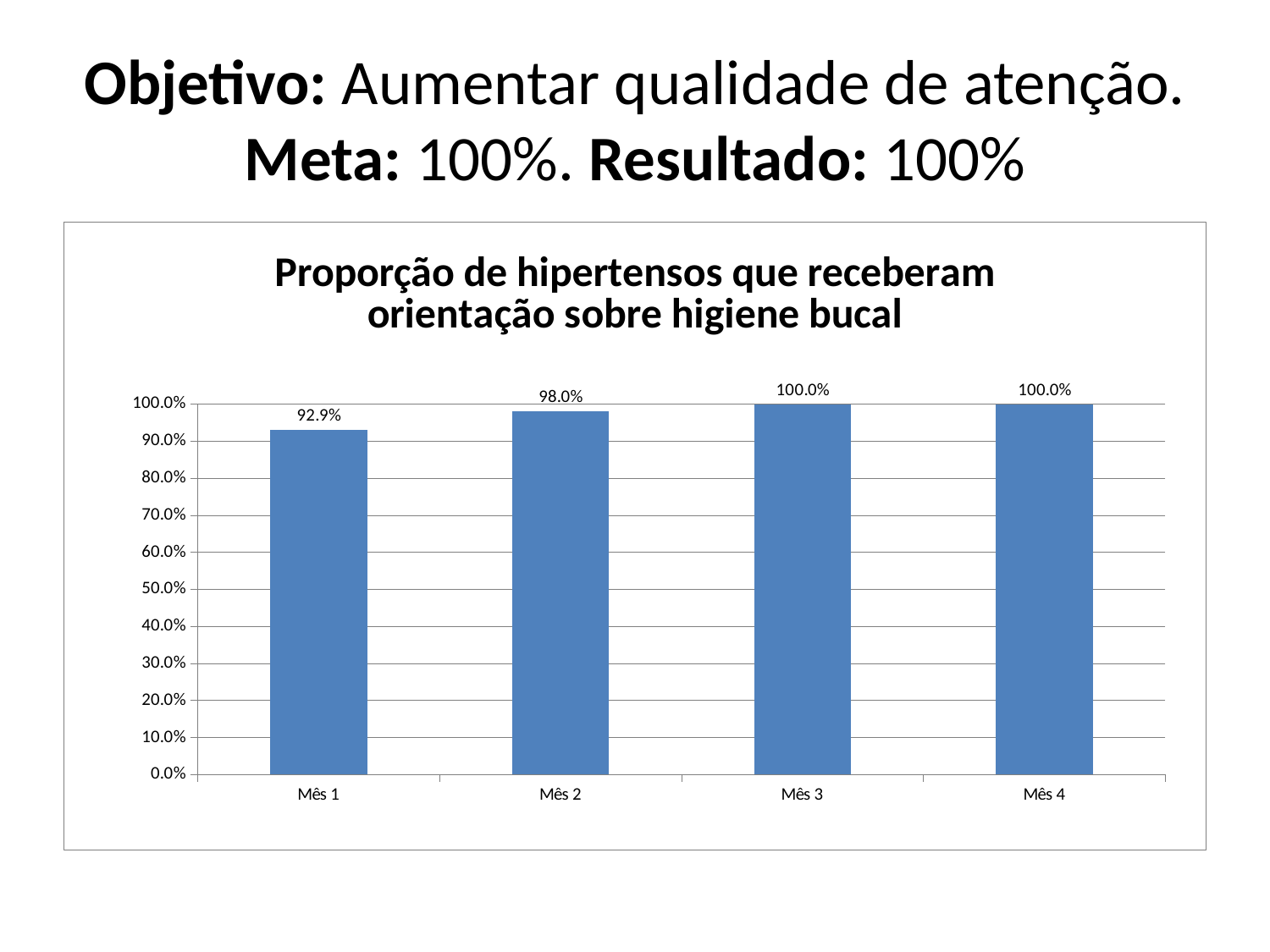
How many months are shown on the x axis? 4 What is the difference between the values for Mês 3 and Mês 1? 7.1% Do the values rise or fall from Mês 1 to Mês 4? rise What is the value for Mês 2? 98.0% What is the value for Mês 3? 100.0% Is the value for Mês 1 greater or less than 90.0%? greater What is the title of the chart? Proporção de hipertensos que receberam orientação sobre higiene bucal What is the value for Mês 1? 92.9% Which is larger, the value for Mês 1 or the value for Mês 2? Mês 2 Which month has the lowest value? Mês 1 What kind of chart is shown on the slide? bar chart What is the difference between the values for Mês 2 and Mês 1? 5.1%